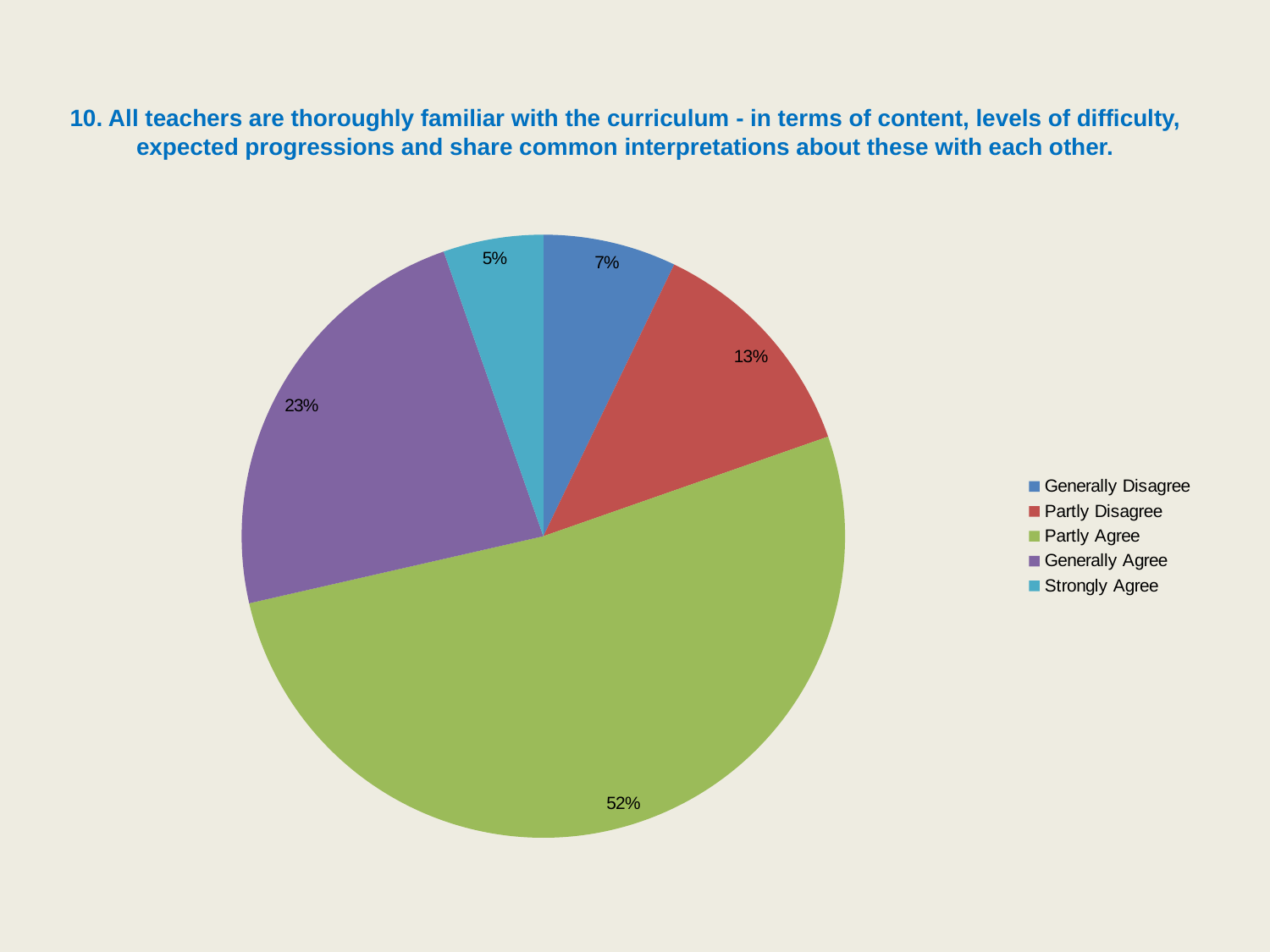
What percentage of respondents chose Generally Agree? 23% What percentage of respondents chose Generally Disagree? 7% What is the difference in percentage points between Partly Agree and Generally Agree? 29 What percentage of respondents chose Strongly Agree? 5% Which response category has the largest share of the pie? Partly Agree How many categories does the legend list? 5 What percentage of respondents chose Partly Disagree? 13% What percentage of respondents chose Partly Agree? 52% Which is larger, the share for Partly Disagree or the share for Generally Disagree? Partly Disagree What kind of chart is shown on the slide? pie chart Which response category has the smallest share of the pie? Strongly Agree What colour is the Partly Agree slice? green